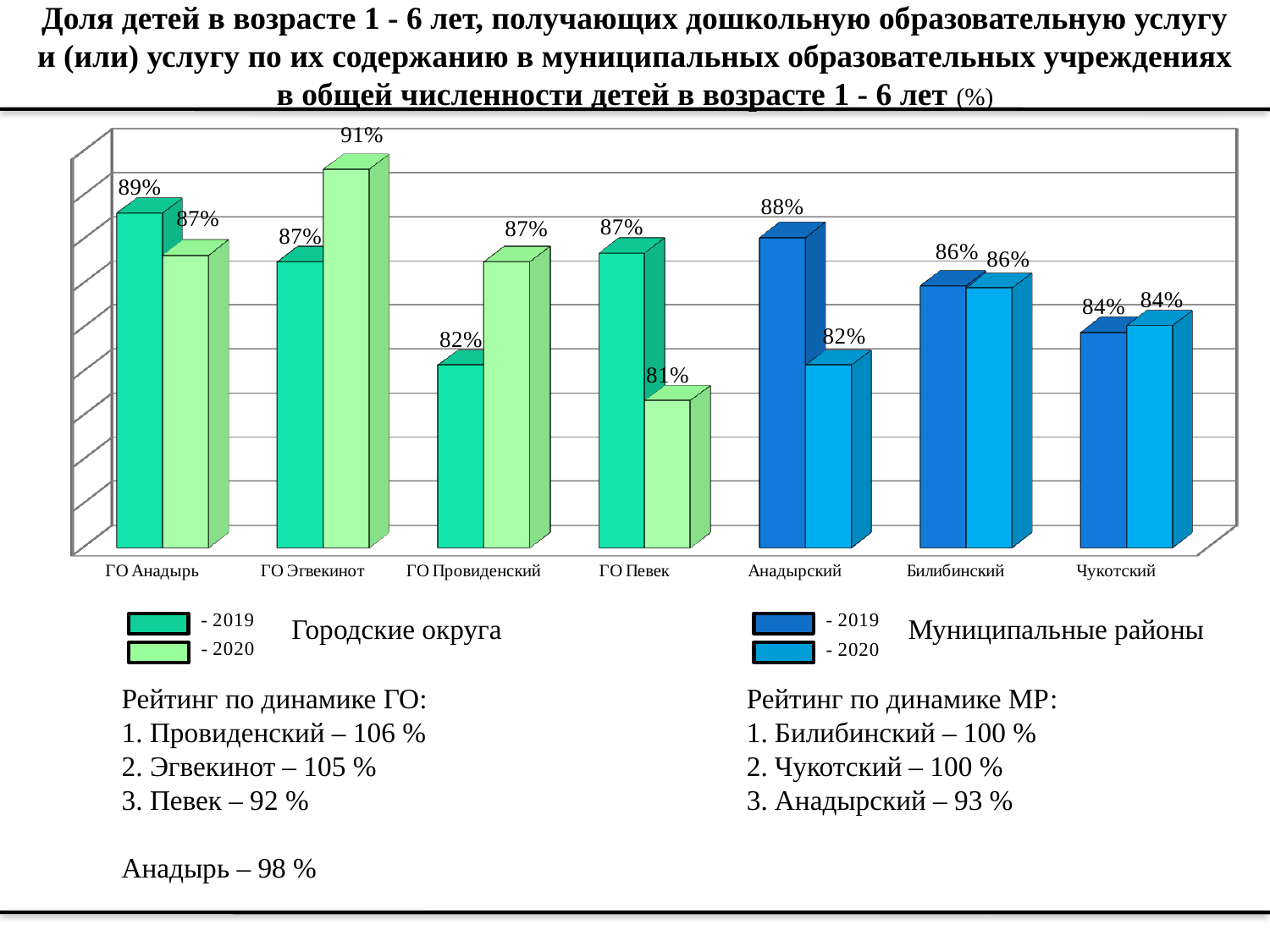
What kind of chart is shown on the slide? Bar chart Which category has the highest 2020 value? ГО Эгвекинот Which category has the lowest 2020 value? ГО Певек Which category has the lowest 2019 value? ГО Провиденский Which two years are listed in the legend? 2019 and 2020 What is the difference between the 2020 and 2019 values for ГО Провиденский? 5% What is the 2020 value for ГО Эгвекинот? 91% What is the 2020 value for Анадырский? 82% How many categories are shown on the x axis? 7 What is the 2019 value for Чукотский? 84% Which is larger for ГО Певек, the 2019 value or the 2020 value? 2019 What is the 2019 value for ГО Анадырь? 89%